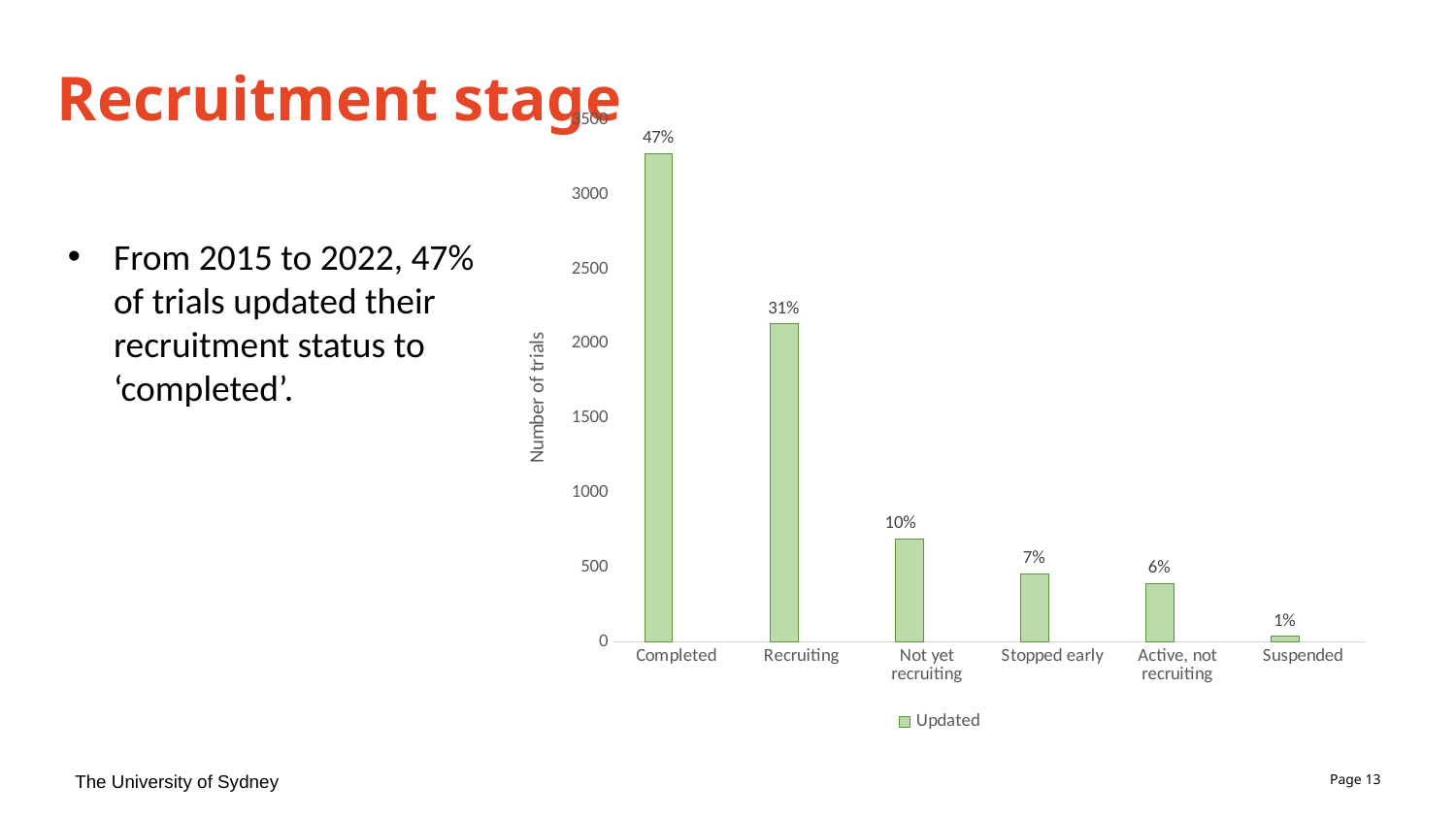
What percentage label is shown above the Active, not recruiting bar? 6% What percentage label is shown above the Suspended bar? 1% What kind of chart is shown on the slide? Bar chart What percentage label is shown above the Completed bar? 47% Is the number of trials for Completed greater or less than 3000? greater Which recruitment stage has the lowest number of trials? Suspended Which recruitment stage has the highest number of trials? Completed What percentage label is shown above the Recruiting bar? 31% Which has more trials, Not yet recruiting or Stopped early? Not yet recruiting What is the label on the vertical axis of the chart? Number of trials How many recruitment stage categories are shown on the x axis? 6